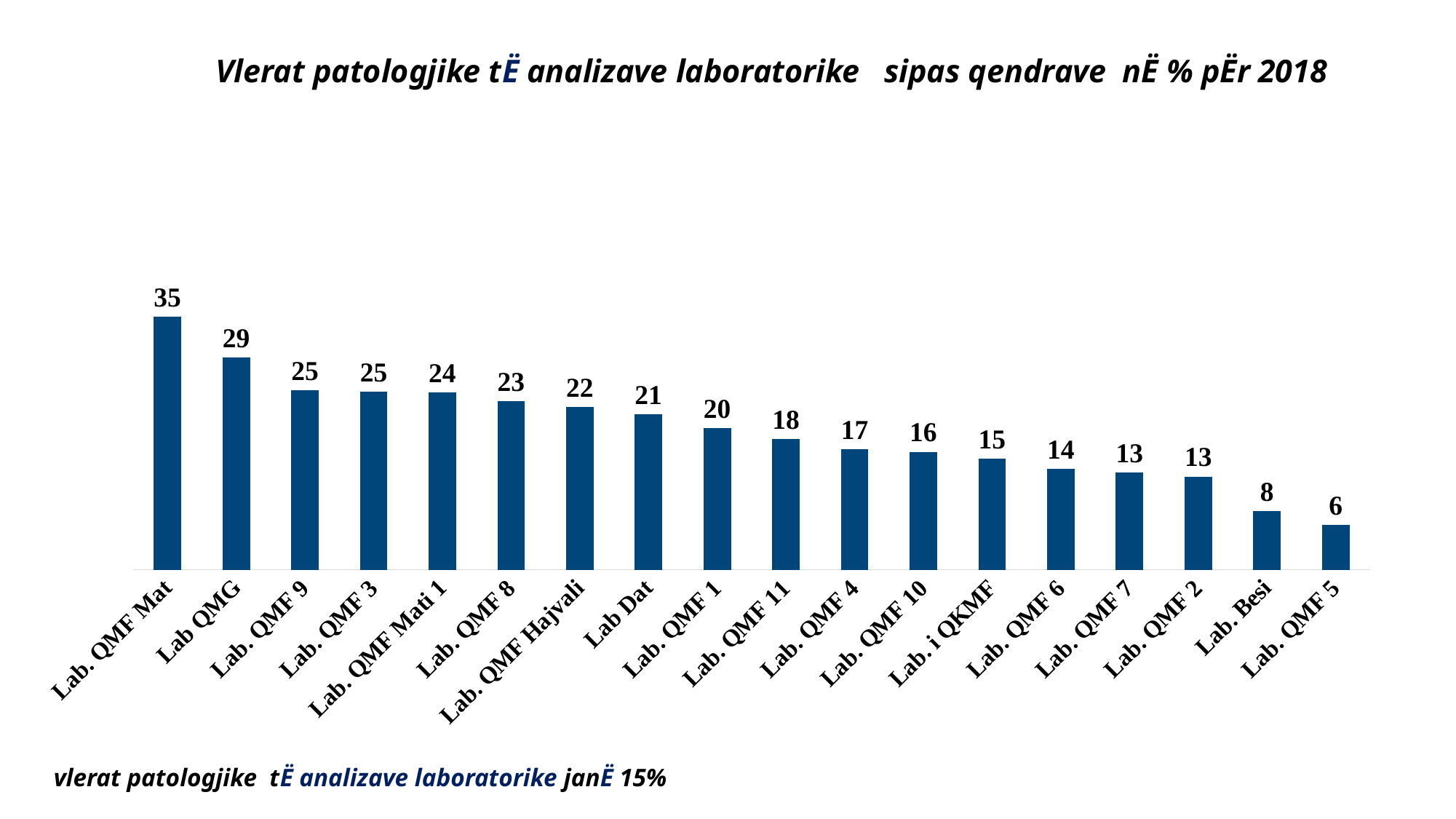
What is the value for Lab. QMF Hajvali? 22 What is the value for Lab. Besi? 8 What is the difference between the values for Lab. QMF Mat and Lab QMG? 6 Which category has the highest value? Lab. QMF Mat Do the values rise or fall from left to right along the x axis? Fall What is the value for Lab. QMF Mat? 35 Which is larger, the value for Lab. QMF 8 or the value for Lab. QMF 4? Lab. QMF 8 What is the value for Lab. i QKMF? 15 What kind of chart is shown on the slide? Bar chart What is the difference between the values for Lab Dat and Lab. QMF 5? 15 How many categories are shown in the chart? 18 Which category has the lowest value? Lab. QMF 5